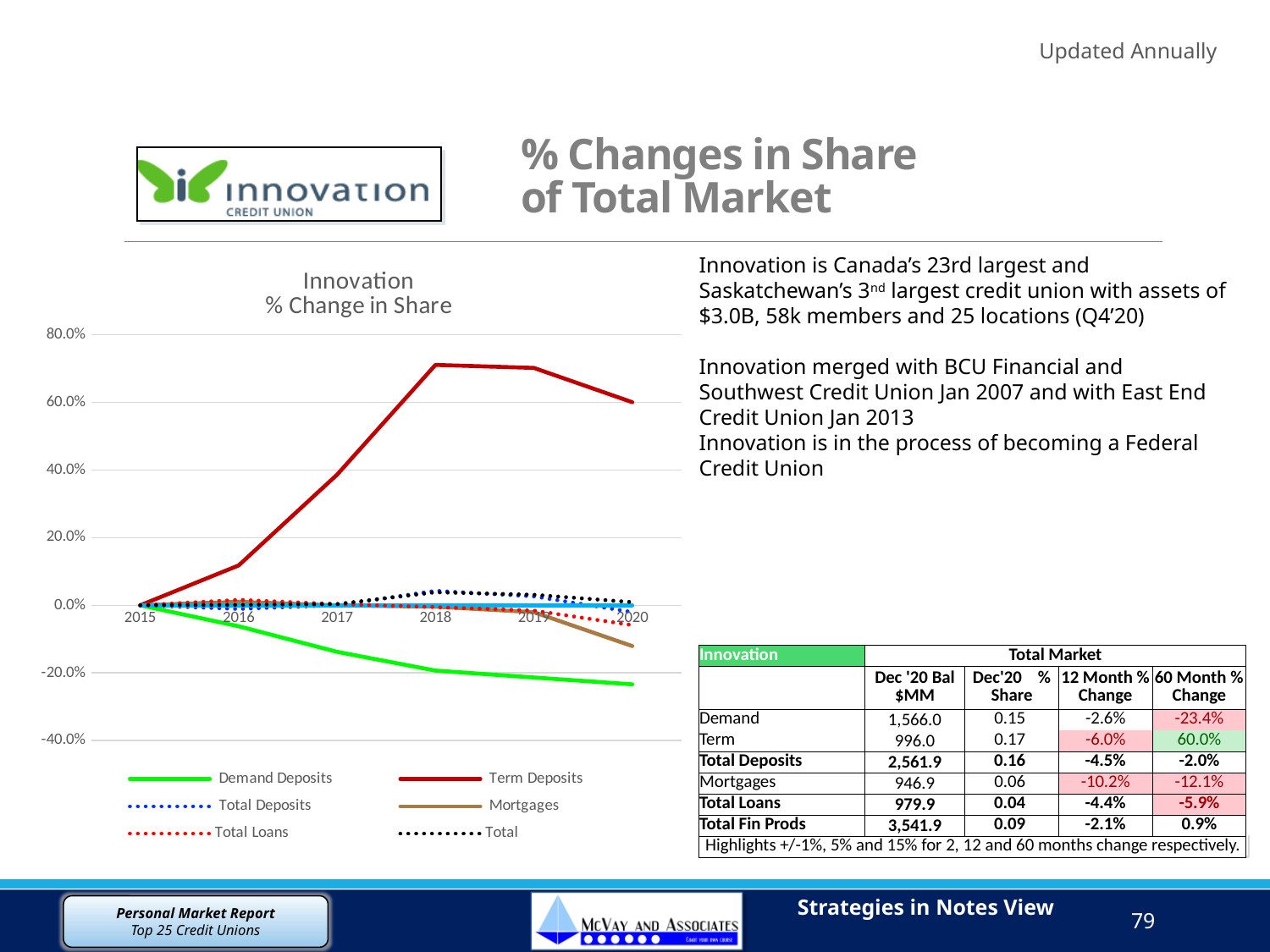
Does the Demand Deposits line rise or fall from 2015 to 2020? fall What kind of chart is shown on the slide? line chart How many years are shown along the x axis of the chart? 6 Is the value for Demand Deposits in 2020 greater or less than -20.0%? less Which series has the lowest value in 2020? Demand Deposits How many series does the chart's legend list? 6 In 2020, which is larger: Term Deposits or Mortgages? Term Deposits What is the title of the chart? Innovation % Change in Share Does the Term Deposits line rise or fall from 2015 to 2018? rise Which series has the highest value in 2020? Term Deposits Is the value for Term Deposits in 2016 greater or less than 20.0%? less Is the value for Term Deposits in 2018 greater or less than 60.0%? greater